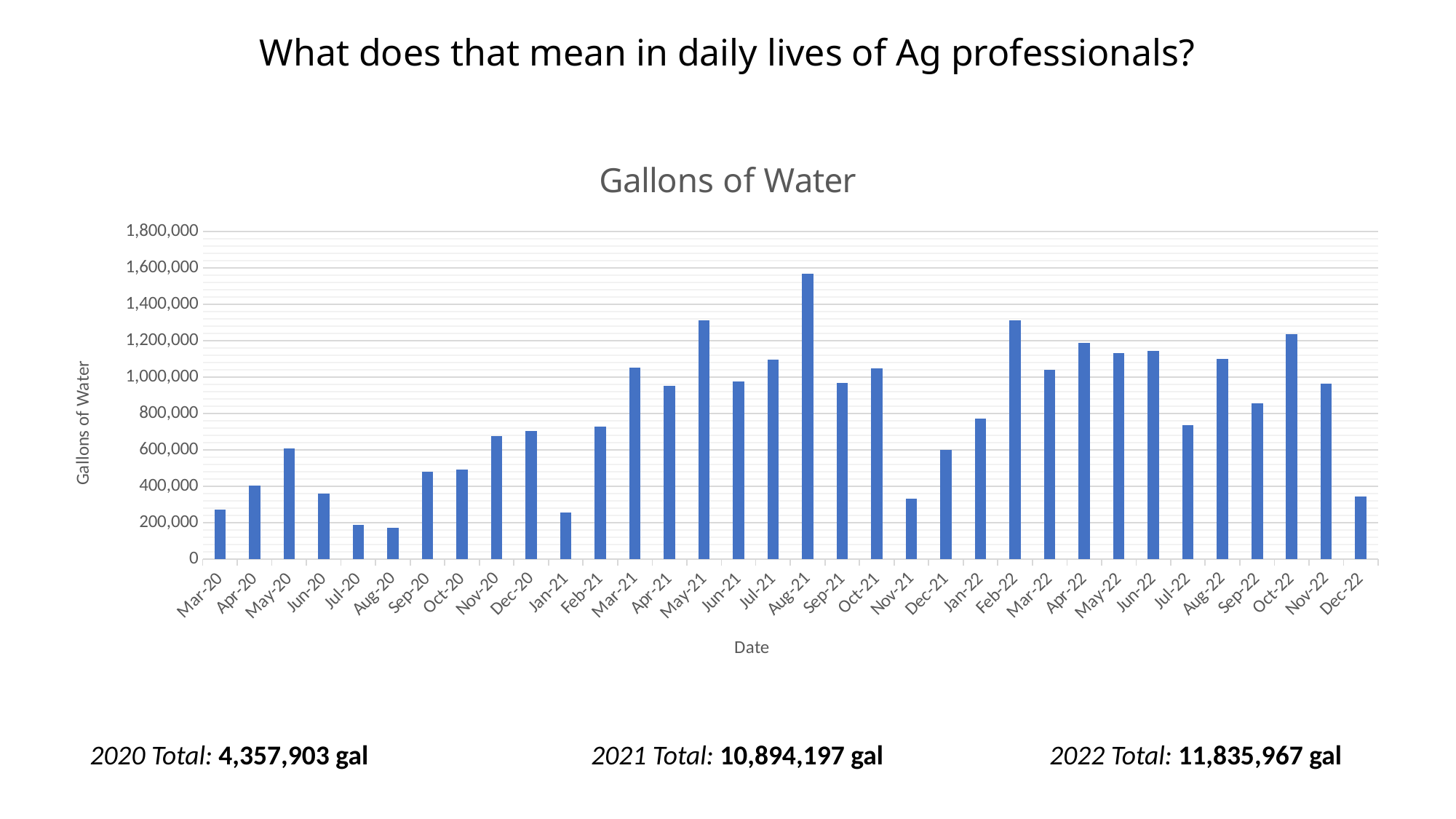
Is the value for Dec-22 greater or less than 600,000? less How many months (bars) are plotted in the chart? 34 What is the label of the x axis? Date Is the value for Nov-21 greater or less than 400,000? less What is the title of the chart? Gallons of Water Is the value for Aug-21 greater or less than 1,400,000? greater Which is larger, the value for Mar-21 or the value for Mar-20? Mar-21 Which month has the highest gallons of water? Aug-21 What kind of chart is shown on the slide? bar chart Which is larger, the value for Oct-22 or the value for Sep-22? Oct-22